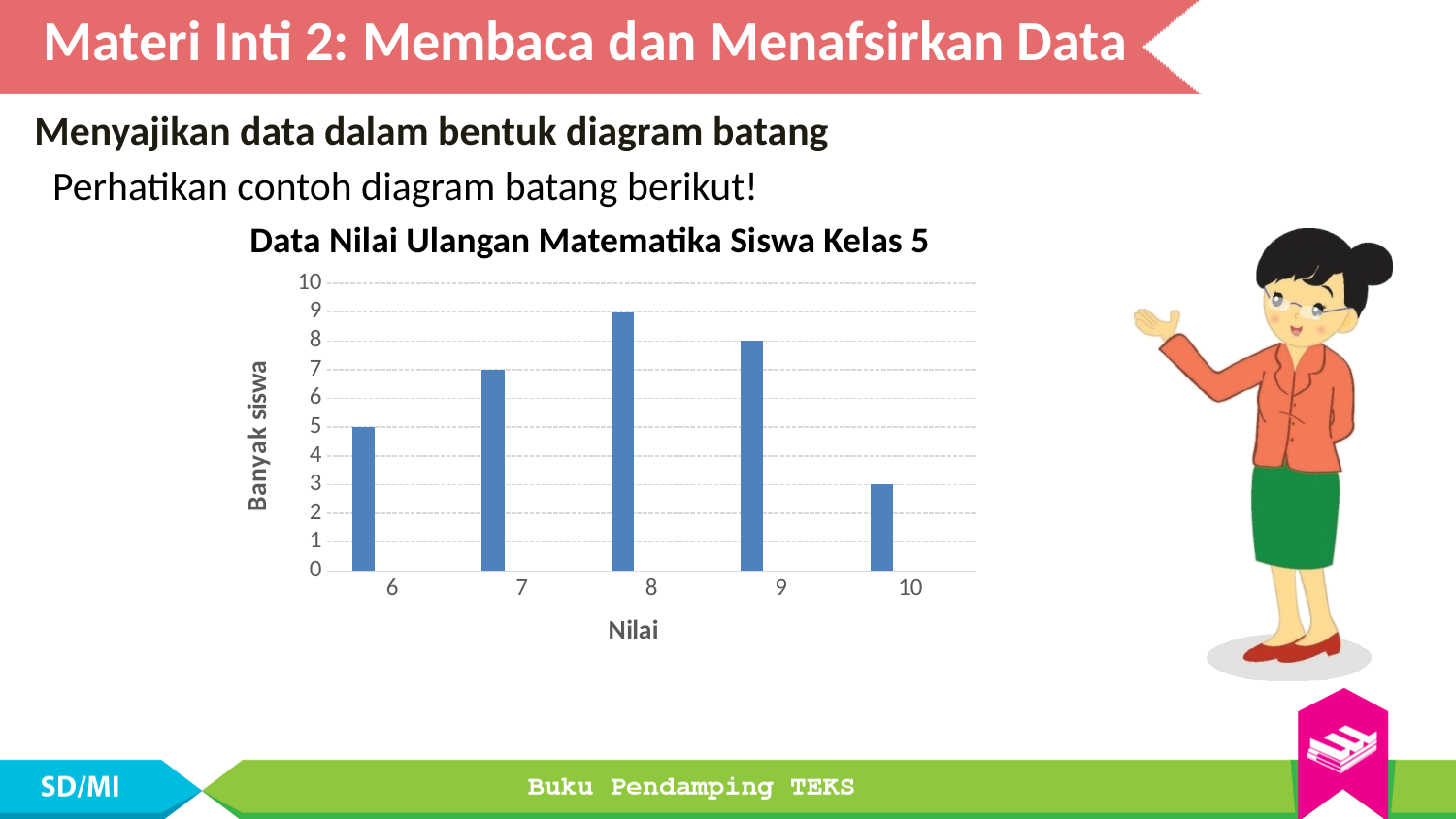
What is the title of the chart? Data Nilai Ulangan Matematika Siswa Kelas 5 What type of chart is shown on the slide? Bar chart How many students scored a Nilai of 10? 3 Which Nilai has the lowest number of students? 10 Which Nilai has the highest number of students? 8 Which has more students: Nilai 7 or Nilai 9? Nilai 9 How many students (Banyak siswa) scored a Nilai of 8? 9 What is the label of the vertical axis? Banyak siswa What is the difference between the number of students with Nilai 8 and Nilai 10? 6 How many students scored a Nilai of 6? 5 How many Nilai categories are shown on the x axis? 5 Is the number of students with Nilai 9 greater or less than 5? greater